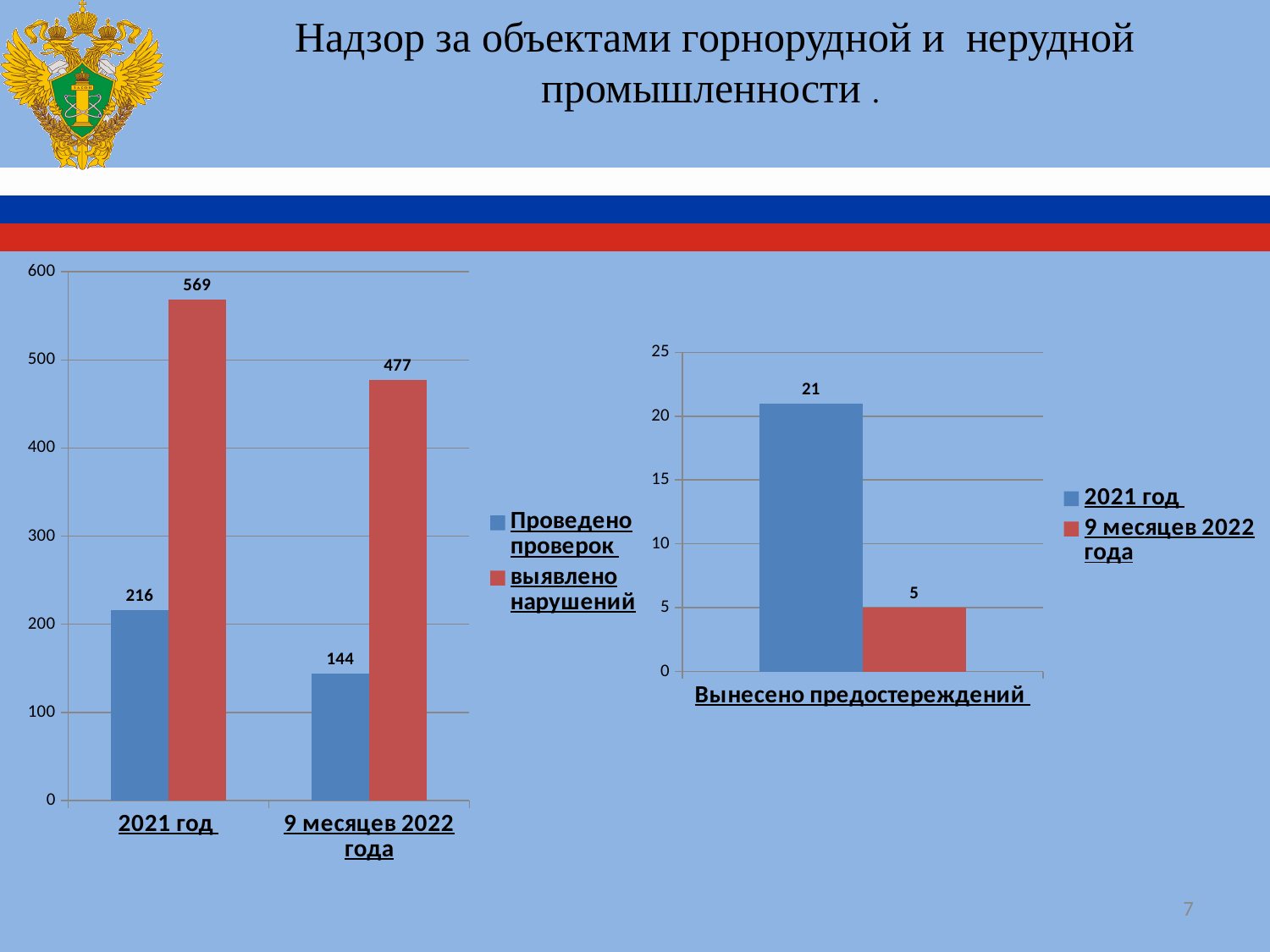
In the left chart, what is the value of 'выявлено нарушений' for '9 месяцев 2022 года'? 477 In the left chart, what is the difference between 'выявлено нарушений' and 'Проведено проверок' for '2021 год'? 353 In the right chart 'Вынесено предостережений', what is the value for '9 месяцев 2022 года'? 5 In the left chart, what is the value of 'Проведено проверок' for '2021 год'? 216 In the right chart 'Вынесено предостережений', what is the value for '2021 год'? 21 In the left chart, which category has the highest value for 'выявлено нарушений'? 2021 год In the right chart 'Вынесено предостережений', what is the difference between the '2021 год' and '9 месяцев 2022 года' values? 16 In the left chart, how many categories are shown on the x axis? 2 What kind of chart is the right chart 'Вынесено предостережений'? bar chart In the right chart, what colour is the bar for '9 месяцев 2022 года'? red In the left chart, which is larger: 'Проведено проверок' for '2021 год' or for '9 месяцев 2022 года'? 2021 год In the left chart, how many series does the legend list? 2